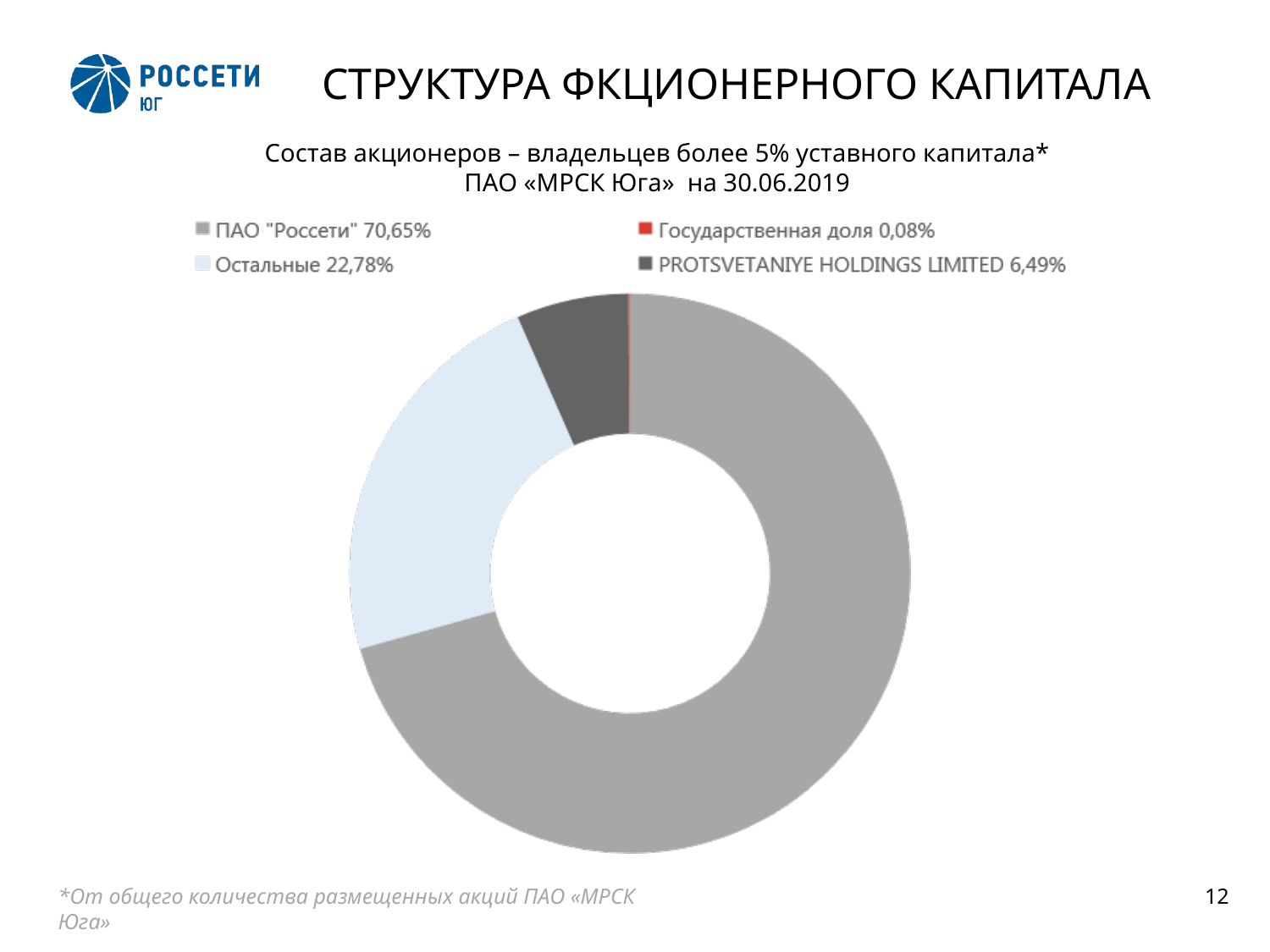
How many shareholder categories does the chart show? 4 Which is larger: the share of Остальные or the share of PROTSVETANIYE HOLDINGS LIMITED? Остальные What share of the share capital does ПАО "Россети" hold according to the chart? 70,65% What is the difference between the shares of Остальные and PROTSVETANIYE HOLDINGS LIMITED? 16,29% Which shareholder category has the largest share in the chart? ПАО "Россети" By how many percentage points does the share of ПАО "Россети" exceed the share of Остальные? 47,87% What type of chart is used on the slide? doughnut chart Which shareholder category has the smallest share in the chart? Государственная доля What share is shown for Остальные in the chart? 22,78% What share is shown for PROTSVETANIYE HOLDINGS LIMITED? 6,49% What share is shown for Государственная доля? 0,08% As of what date is the shareholder structure shown in the chart? 30.06.2019